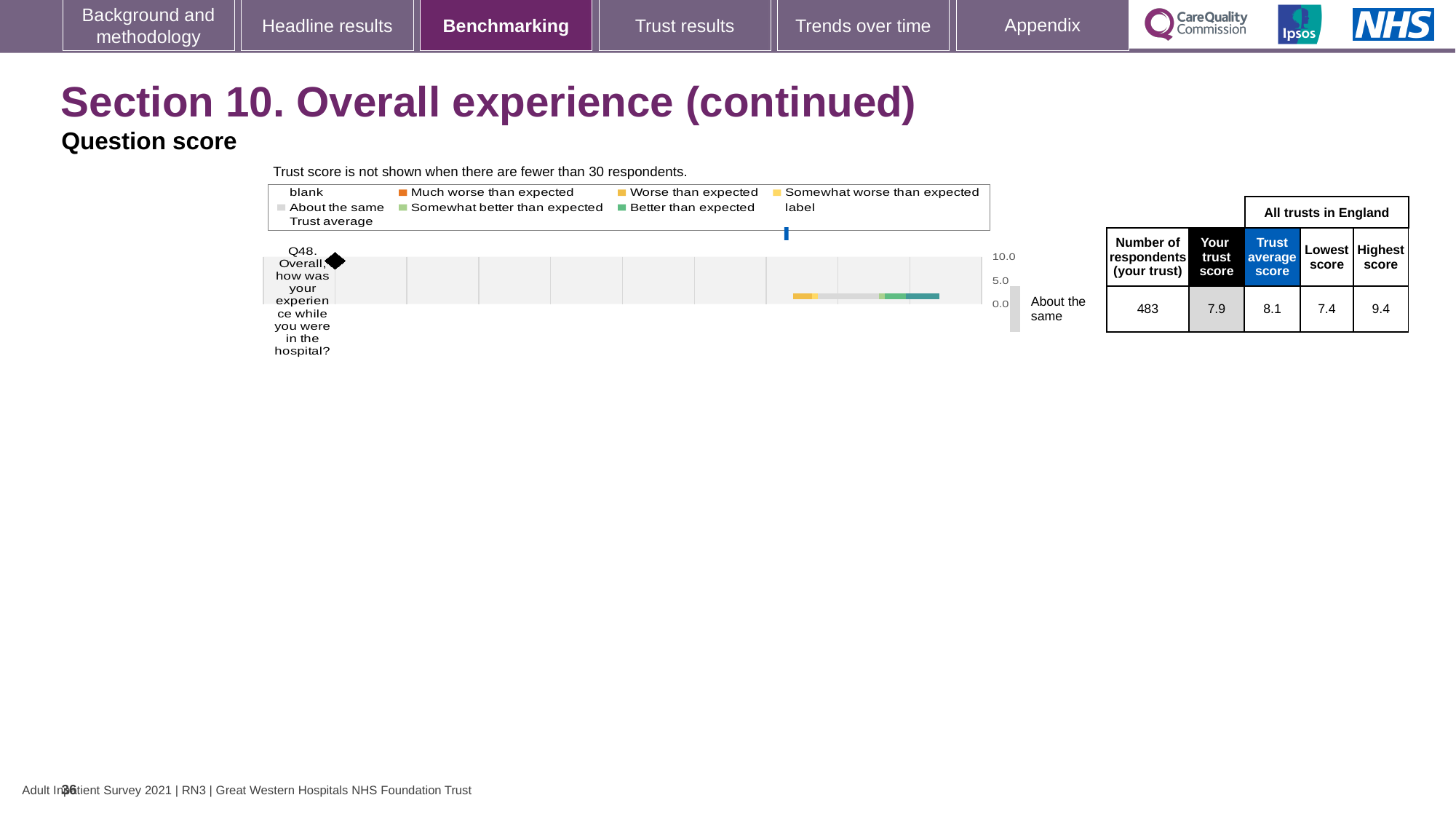
Is your trust score for Q48 greater or less than 5.0? greater How many questions are plotted in the chart? 1 What kind of chart is used to show the Q48 benchmarking result? Bar chart What benchmarking category label is shown next to the chart for Q48? About the same What is the trust average score for Q48 across all trusts in England? 8.1 What is the difference between the highest and lowest scores for Q48 across all trusts in England? 2.0 Which is larger for Q48: your trust score or the trust average score? Trust average score What is the highest score among all trusts in England for Q48? 9.4 What is the 'Your trust score' for Q48 shown in the table? 7.9 By how much does the trust average score exceed your trust score for Q48? 0.2 What is the lowest score among all trusts in England for Q48? 7.4 How many respondents from your trust answered Q48? 483